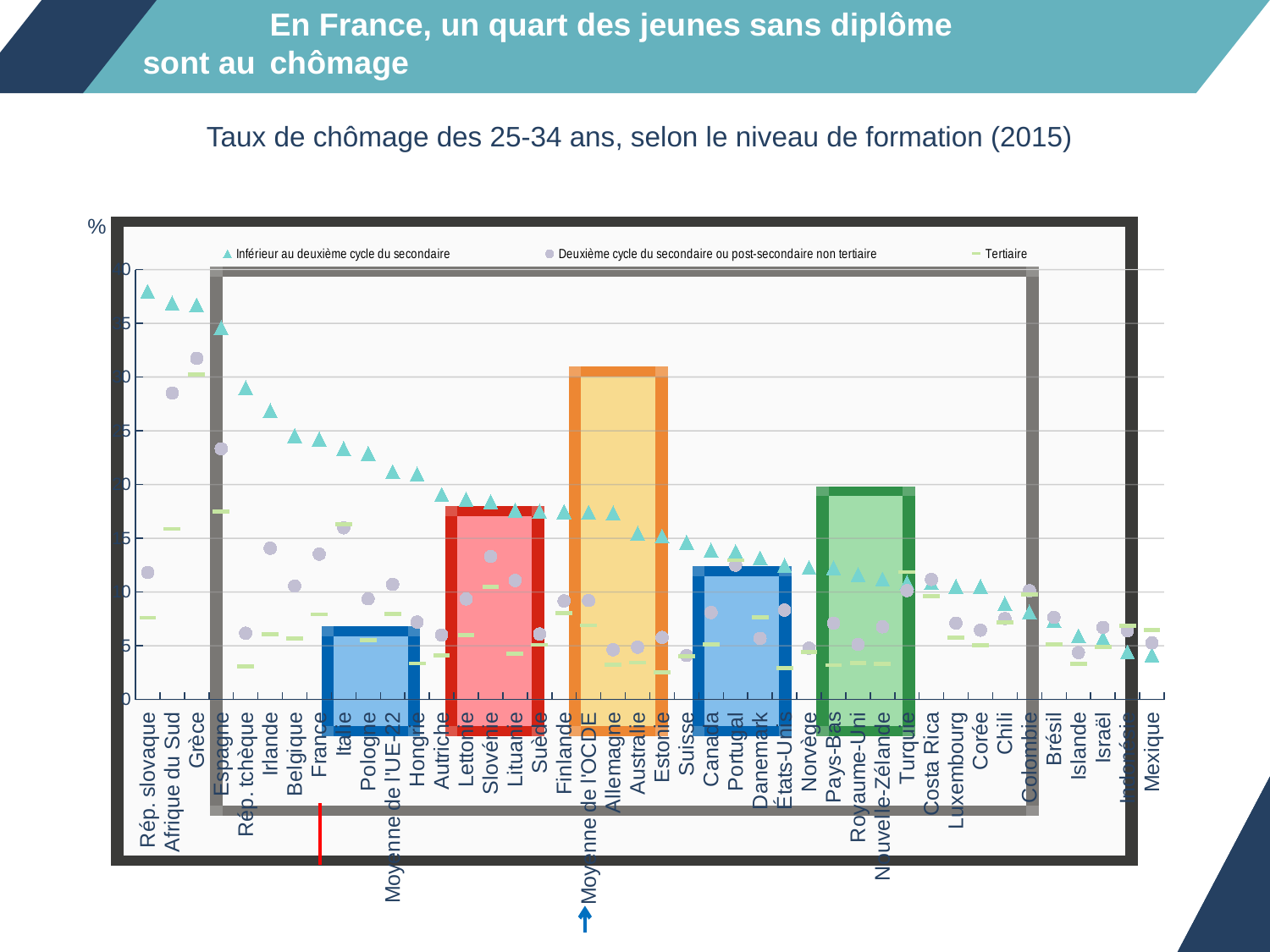
Is the 'Tertiaire' value for Espagne greater or less than 20? less Is the 'Inférieur au deuxième cycle du secondaire' value for Moyenne de l'OCDE greater or less than 20? less Is the 'Inférieur au deuxième cycle du secondaire' value for France greater or less than 20? greater How many series does the chart legend list? 3 Do the values for 'Inférieur au deuxième cycle du secondaire' rise or fall from left to right along the x axis? fall Which has the larger 'Deuxième cycle du secondaire ou post-secondaire non tertiaire' value, Grèce or Afrique du Sud? Grèce What is the title of the chart? Taux de chômage des 25-34 ans, selon le niveau de formation (2015) Which country has the highest value for 'Inférieur au deuxième cycle du secondaire'? Rép. slovaque Which has the larger 'Inférieur au deuxième cycle du secondaire' value, Espagne or France? Espagne Which marker shape is used for the 'Inférieur au deuxième cycle du secondaire' series? triangle